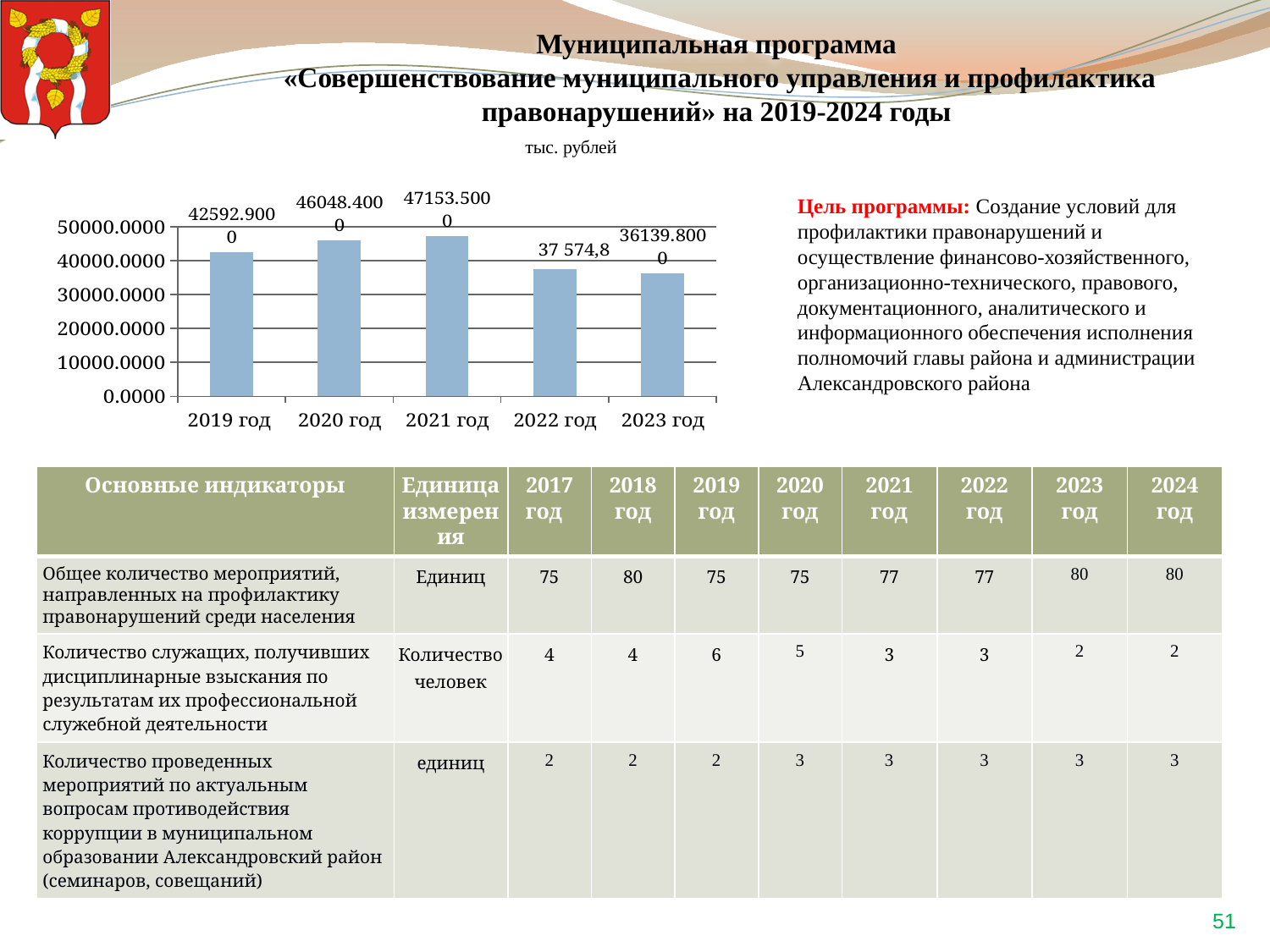
Which is larger in the bar chart, the value for 2019 год or the value for 2020 год? 2020 год What is the value for 2023 год in the bar chart? 36139.8000 Which year has the highest value in the bar chart? 2021 год What unit is stated above the bar chart? тыс. рублей Is the value for 2022 год in the bar chart greater or less than 40000.0000? less How many years (categories) are plotted in the bar chart? 5 Which year has the lowest value in the bar chart? 2023 год What is the value for 2020 год in the bar chart? 46048.4000 Do the values in the bar chart rise or fall from 2021 год to 2023 год? fall What kind of chart is shown on the slide? bar chart What is the value for 2021 год in the bar chart? 47153.5000 What is the value for 2022 год in the bar chart? 37 574,8